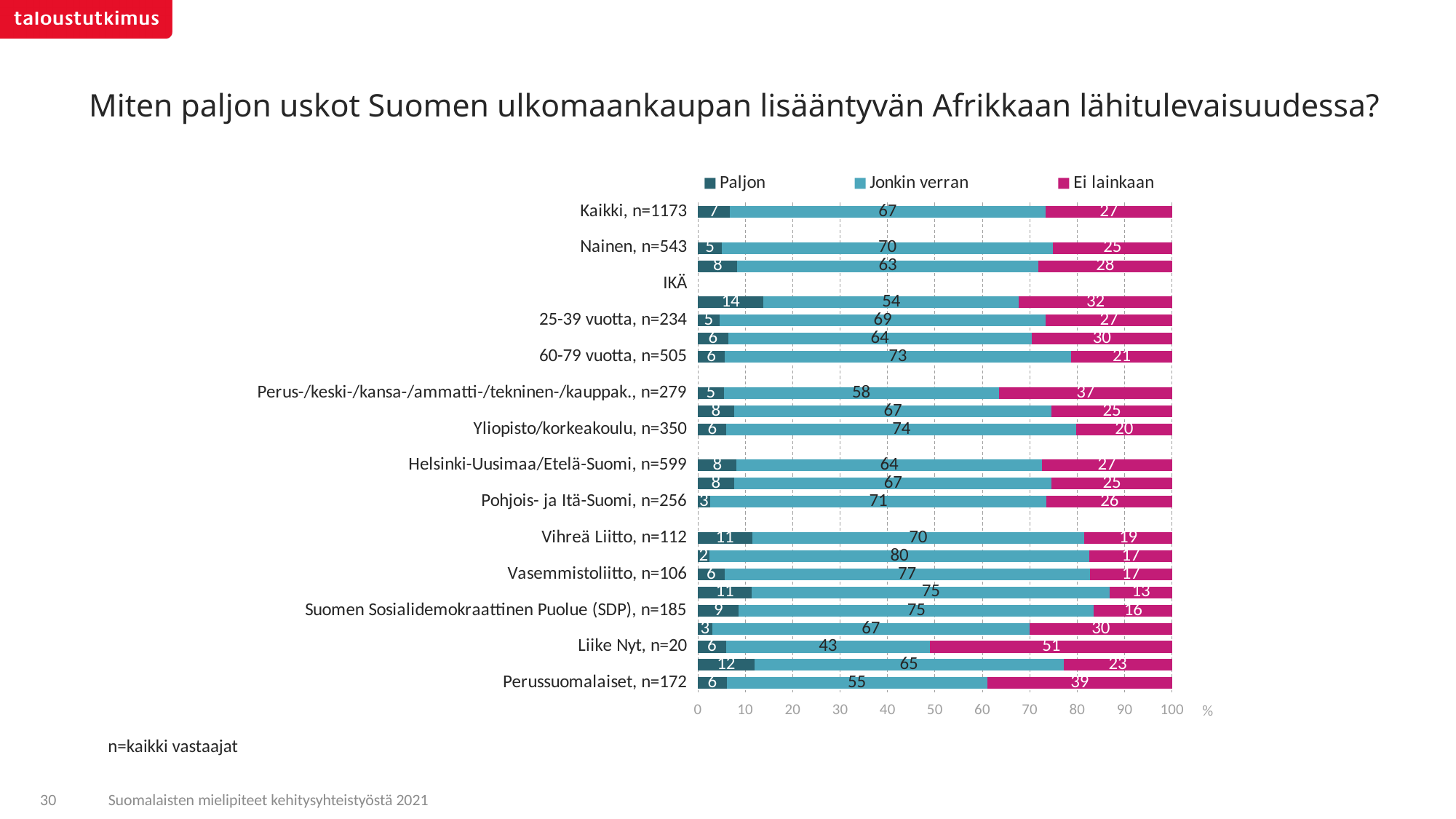
What kind of chart is shown on the slide? Stacked bar chart What percentage of all respondents (Kaikki, n=1173) answered "Jonkin verran"? 67 Which group has the lowest "Jonkin verran" value? Liike Nyt, n=20 What is the "Paljon" value for Vihreä Liitto, n=112? 11 What is the difference between the "Ei lainkaan" values for Perussuomalaiset, n=172 and Vasemmistoliitto, n=106? 22 Which legend entry is shown in pink/magenta? Ei lainkaan How many series does the legend list? 3 Which has a larger "Jonkin verran" value: Yliopisto/korkeakoulu, n=350 or Perus-/keski-/kansa-/ammatti-/tekninen-/kauppak., n=279? Yliopisto/korkeakoulu, n=350 Which group has the highest "Ei lainkaan" value? Liike Nyt, n=20 What is the total of the stacked bar for Liike Nyt, n=20? 100 What is the "Ei lainkaan" value for Liike Nyt, n=20? 51 What is the "Paljon" value for Pohjois- ja Itä-Suomi, n=256? 3